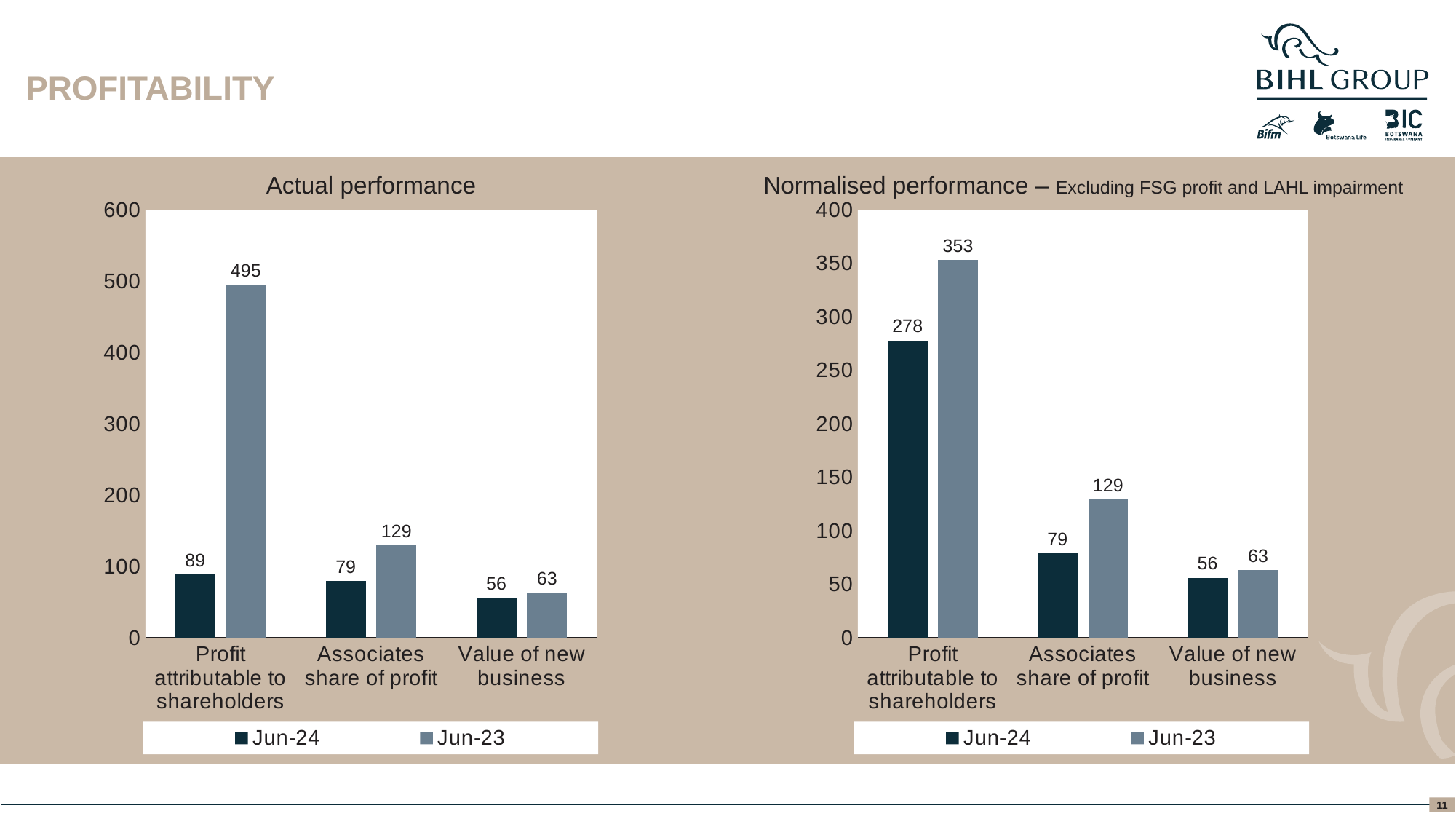
What type of chart is the 'Actual performance' chart? Bar chart In the 'Normalised performance' chart, what is the Jun-24 value for Profit attributable to shareholders? 278 In the 'Normalised performance' chart, what is the Jun-23 value for Value of new business? 63 How many series does the legend of the 'Normalised performance' chart list? 2 In the 'Actual performance' chart, what is the difference between the Jun-23 and Jun-24 values for Profit attributable to shareholders? 406 In the 'Actual performance' chart, which category has the highest Jun-23 value? Profit attributable to shareholders In the 'Normalised performance' chart, which is larger for Profit attributable to shareholders: Jun-24 or Jun-23? Jun-23 In the 'Actual performance' chart, what is the Jun-23 value for Profit attributable to shareholders? 495 In the 'Actual performance' chart, what is the Jun-24 value for Associates share of profit? 79 How many categories are shown on the x axis of the 'Actual performance' chart? 3 In the 'Normalised performance' chart, what is the difference between the Jun-23 and Jun-24 values for Associates share of profit? 50 In the 'Normalised performance' chart, which category has the lowest Jun-24 value? Value of new business